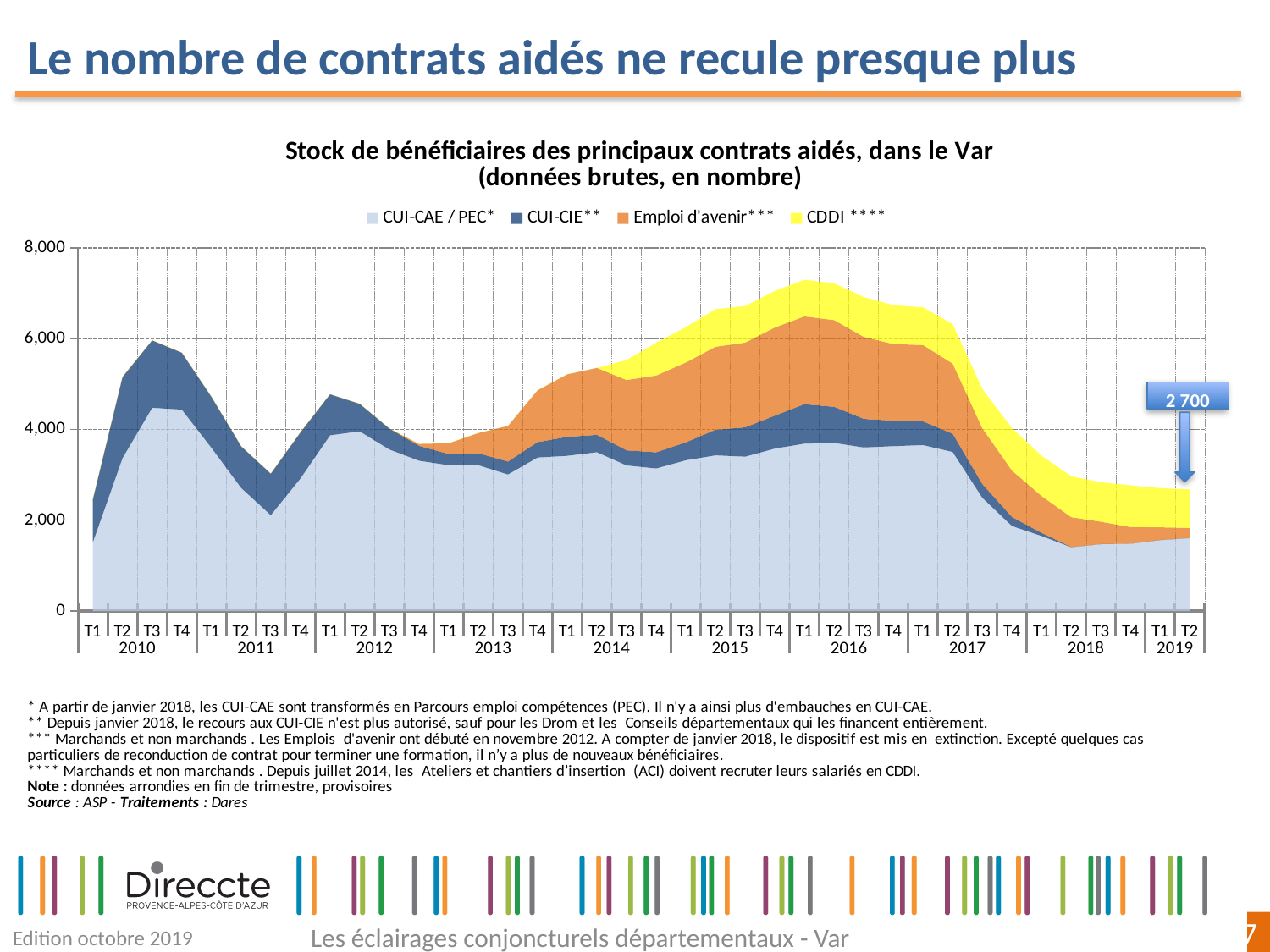
What is the title of the chart? Stock de bénéficiaires des principaux contrats aidés, dans le Var (données brutes, en nombre) How many quarterly points are plotted along the x axis, from T1 2010 to T2 2019? 38 Which series is shown in yellow in the legend? CDDI **** Which is larger, the total stock at T1 2016 or at T1 2010? T1 2016 Does the total stock of beneficiaries rise or fall between T1 2016 and T2 2019? Fall What kind of chart is shown on the slide? Stacked area chart In which year does the total stock of beneficiaries reach its peak? 2016 What total value is labelled for T2 2019 on the chart? 2 700 Is the total stock of beneficiaries at T1 2012 greater or less than 4,000? greater Is the total stock of beneficiaries at T3 2011 greater or less than 4,000? less How many series does the chart legend list? 4 Is the total stock of beneficiaries at T1 2016 greater or less than 6,000? greater